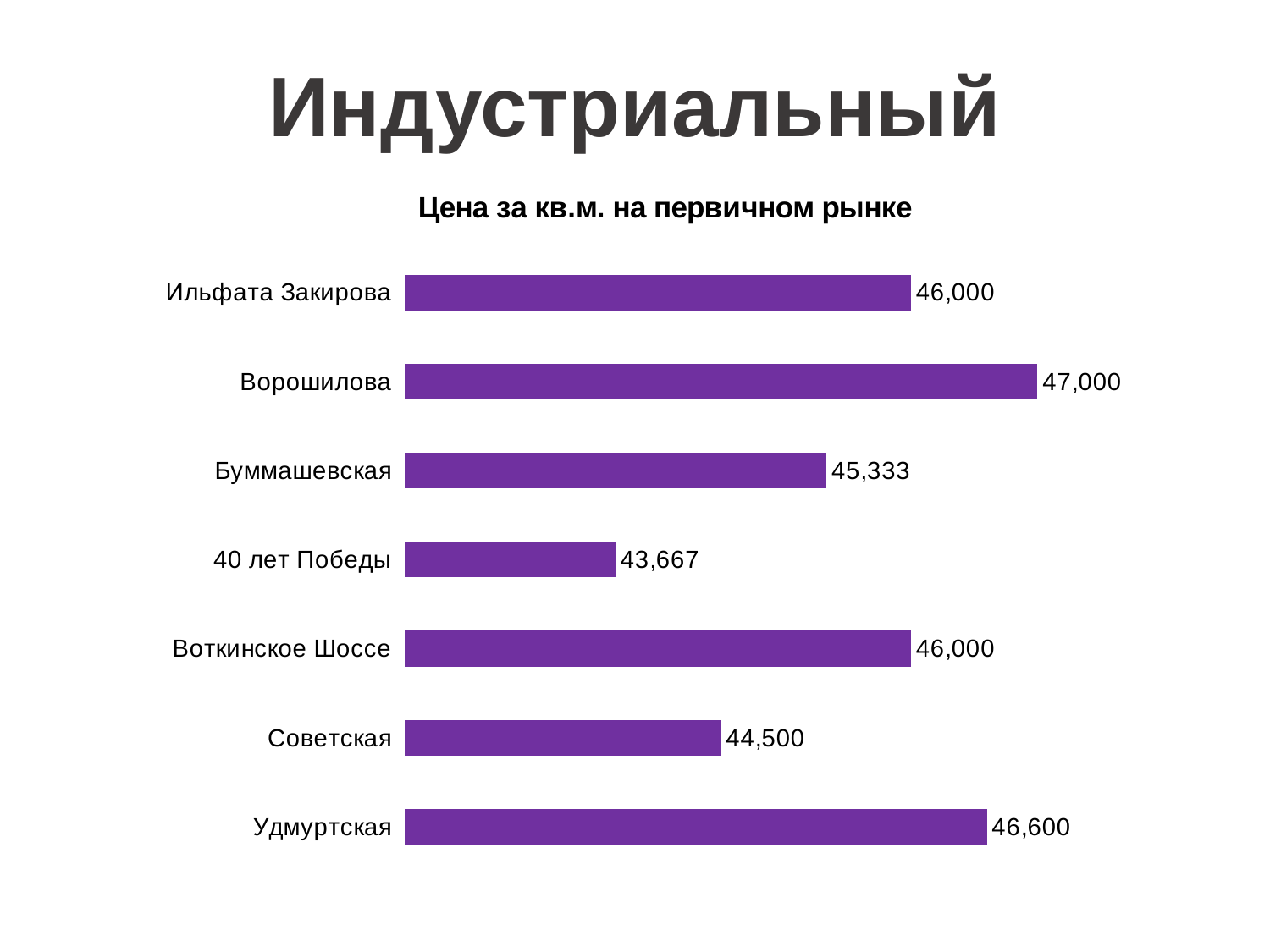
What is the value for Буммашевская? 45,333 What is the value for Ворошилова? 47,000 Which category has the lowest value? 40 лет Победы Which category has the highest value? Ворошилова What is the title of the chart? Цена за кв.м. на первичном рынке What is the value for 40 лет Победы? 43,667 What is the difference between the values for Ворошилова and Советская? 2,500 Which is larger, the value for Буммашевская or the value for Советская? Буммашевская What is the difference between the values for Удмуртская and Воткинское Шоссе? 600 What kind of chart is shown on the slide? Bar chart How many categories are shown in the chart? 7 What is the value for Удмуртская? 46,600